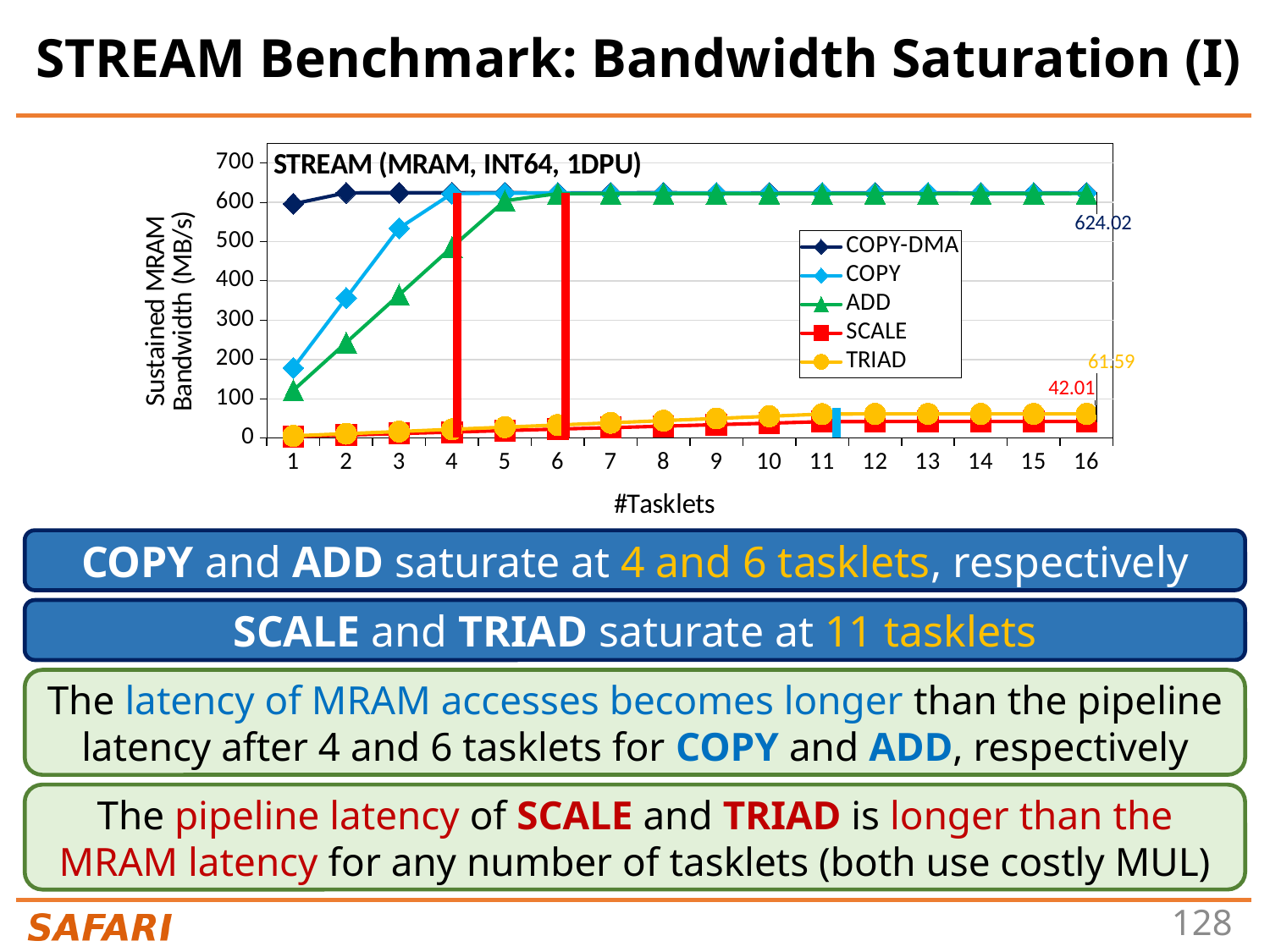
What is the title shown inside the chart area? STREAM (MRAM, INT64, 1DPU) At 16 tasklets, which has the larger labelled value, SCALE or TRIAD? TRIAD What value is labelled for the top (COPY-DMA) line at 16 tasklets? 624.02 Is the value for ADD at 1 tasklet greater or less than 200? less What is the labelled value for TRIAD at 16 tasklets? 61.59 What is the labelled value for SCALE at 16 tasklets? 42.01 What is the difference between the labelled TRIAD and SCALE values at 16 tasklets? 19.58 How many series does the chart legend list? 5 What kind of chart is shown on the slide? line chart Is the value for COPY-DMA at 1 tasklet greater or less than 500? greater How many #Tasklets values are plotted along the x axis? 16 Which series has the lowest value at 16 tasklets? SCALE